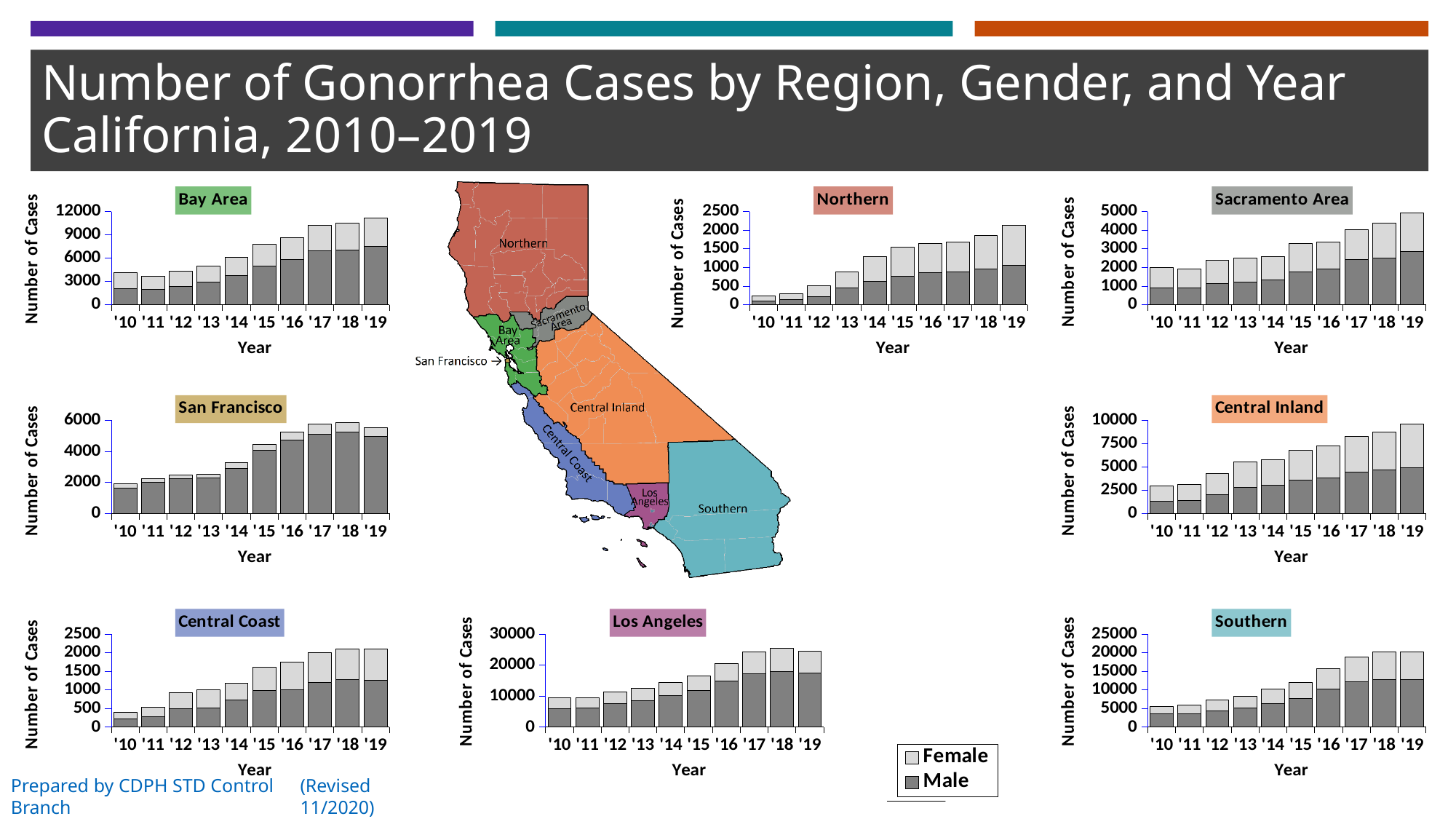
In the Northern chart, is the total number of cases for '10 greater or less than 500? less How many years are shown on the x axis of the Los Angeles chart? 10 In the Central Inland chart, is the total number of cases for '19 greater or less than 7500? greater In the Central Coast chart, is the total number of cases for '19 greater or less than 1500? greater In the Sacramento Area chart, which year has the highest total number of cases? '19 In the Bay Area chart, which is larger for '19: the Male cases or the Female cases? Male Which region's chart has the highest value at the top of its y axis? Los Angeles Which series is shown in the darker gray colour according to the legend? Male What kind of chart is the Bay Area chart? bar chart How many series does the legend list? 2 In the Bay Area chart, do the total number of cases rise or fall from '10 to '19? rise